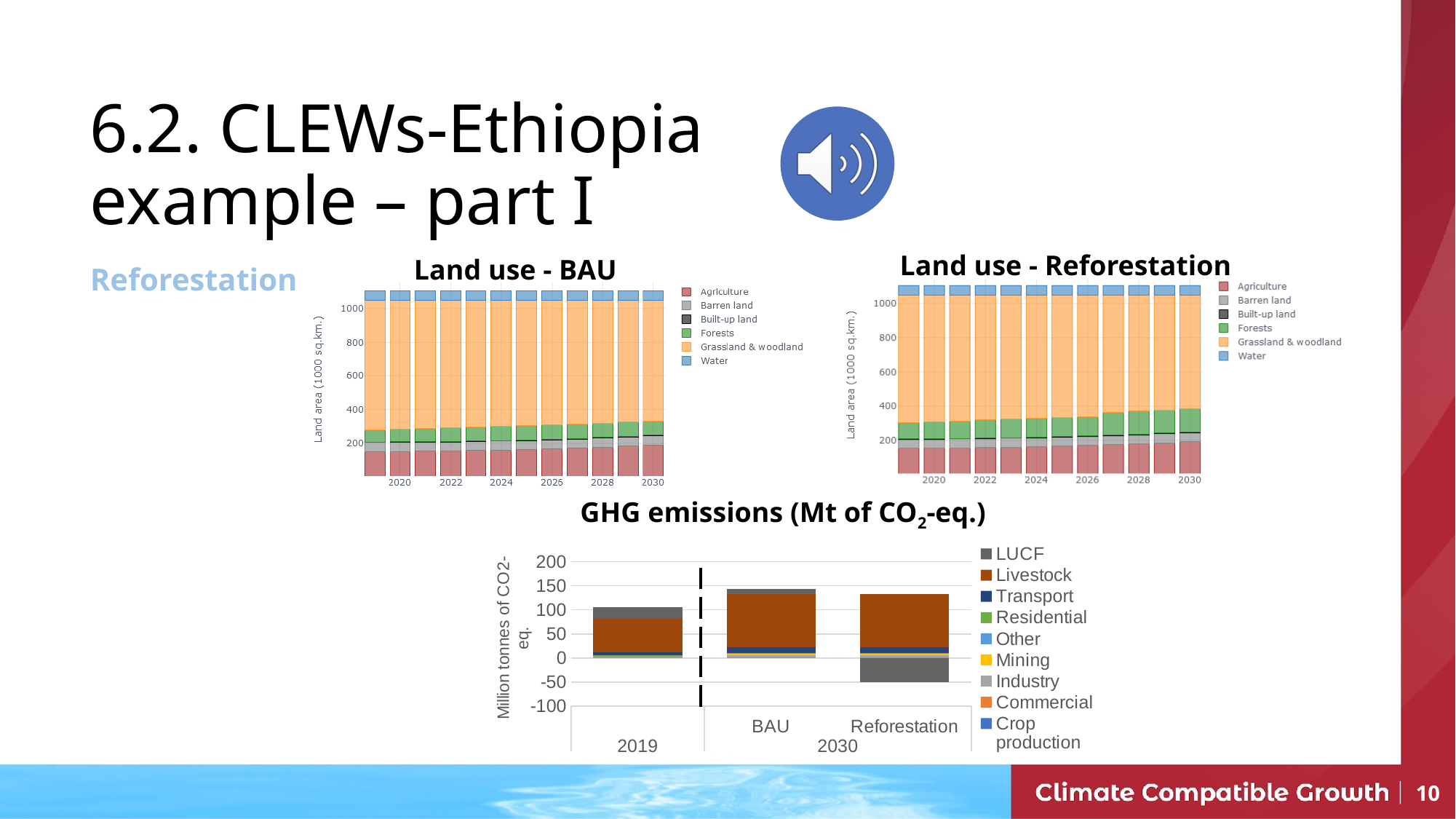
In the "GHG emissions (Mt of CO2-eq.)" chart, which 2030 scenario has a negative LUCF segment? Reforestation How many years (bars) are plotted in the "Land use - Reforestation" chart? 11 In the "GHG emissions (Mt of CO2-eq.)" chart, is the top of the 2019 bar greater or less than 150? less How many series does the legend of the "GHG emissions (Mt of CO2-eq.)" chart list? 9 In the "GHG emissions (Mt of CO2-eq.)" chart, which bar reaches the highest positive value: 2019, BAU 2030 or Reforestation 2030? BAU 2030 In the "Land use - BAU" chart, is the total land area of each bar greater or less than 1000? greater What is the y-axis label of the "Land use - BAU" chart? Land area (1000 sq.km.) How many series does the legend of the "Land use - BAU" chart list? 6 How many bars are plotted in the "GHG emissions (Mt of CO2-eq.)" chart? 3 In the "GHG emissions (Mt of CO2-eq.)" chart, is the top of the BAU 2030 bar greater or less than 100? greater In the "Land use - Reforestation" chart, does the Forests segment rise or fall from 2020 to 2030? rise What kind of chart is the "GHG emissions (Mt of CO2-eq.)" chart? Stacked bar chart